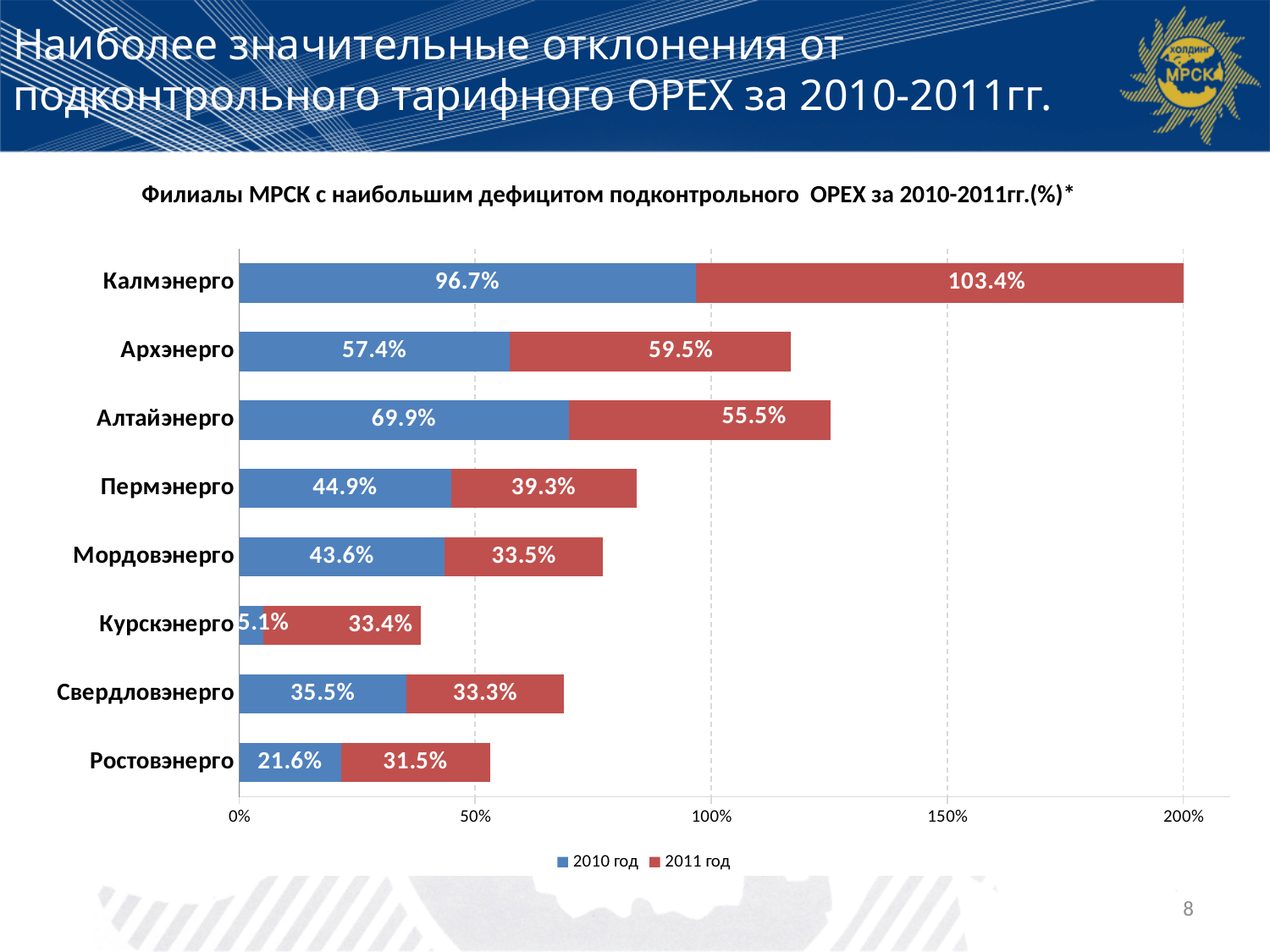
Which series is shown in red in the chart? 2011 год How many series does the legend list? 2 What is the 2011 год value for Архэнерго? 59.5% What is the 2010 год value for Курскэнерго? 5.1% What is the 2010 год value for Калмэнерго? 96.7% How many branches (categories) are shown in the chart? 8 What type of chart is shown on the slide? stacked bar chart Which branch has the highest 2011 год value? Калмэнерго What is the total of the stacked bar for Ростовэнерго? 53.1% Which is larger for Алтайэнерго: the 2010 год value or the 2011 год value? 2010 год Which branch has the lowest 2010 год value? Курскэнерго What is the difference between the 2011 год and 2010 год values for Калмэнерго? 6.7 percentage points